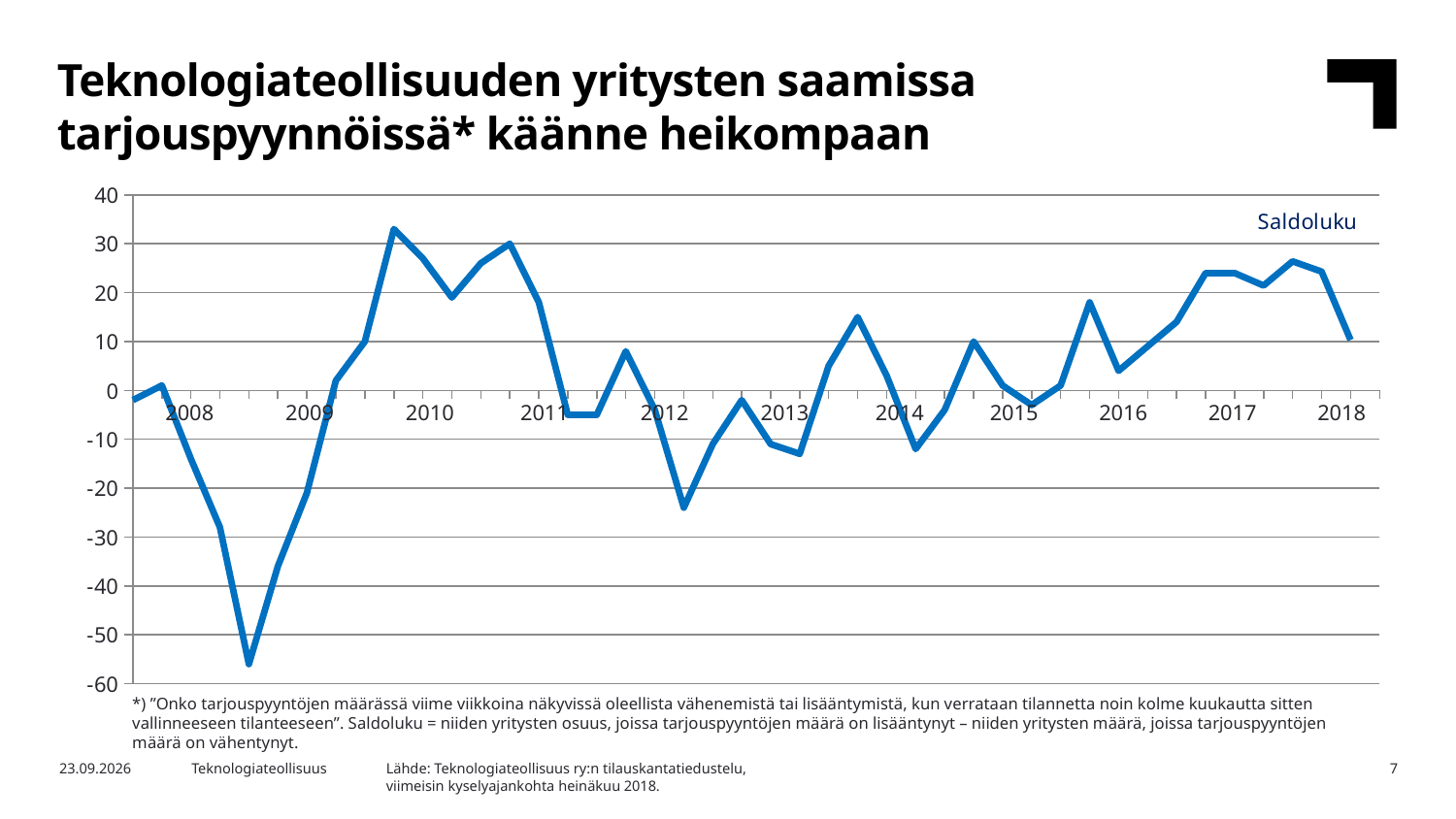
What kind of chart is shown on the slide? line chart Does the line rise or fall between the start of 2008 and the low point in late 2008? fall What is the highest value shown on the y axis of the chart? 40 Is the peak value of the line reached in late 2009 greater or less than 30? greater What is the name of the series plotted in the chart? Saldoluku How many year labels are shown on the x axis of the chart? 11 Is the last plotted value of the line, in 2018, greater or less than 0? greater Is the low point of the line in early 2012 greater or less than -20? less Does the line rise or fall between the last two plotted points in 2018? fall Which is larger: the low point of the line in 2008–2009 or the low point in early 2012? the low point in early 2012 What is the title of the chart on the slide? Teknologiateollisuuden yritysten saamissa tarjouspyynnöissä* käänne heikompaan